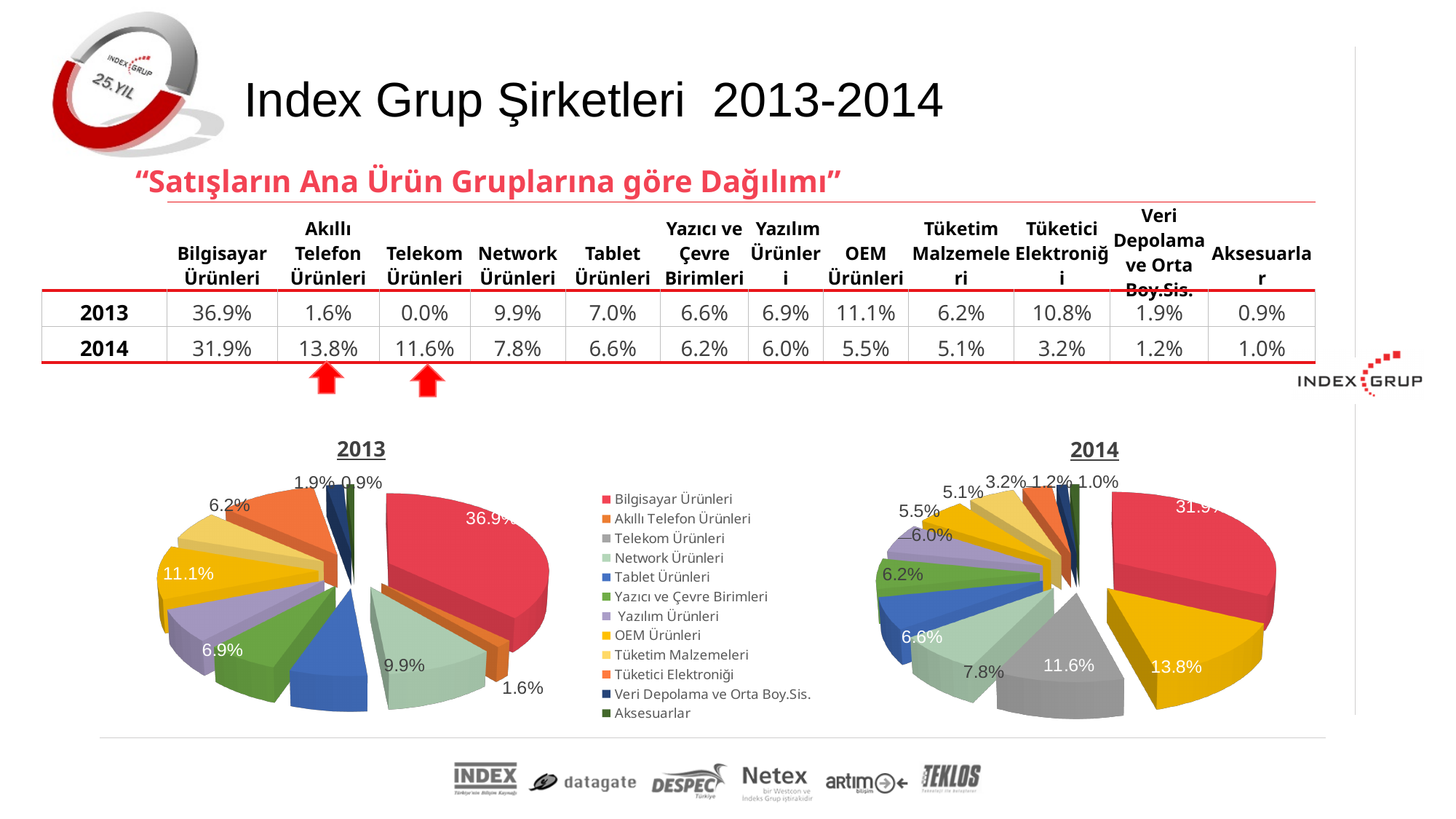
What kind of charts are shown on the slide for 2013 and 2014? Pie charts How many product groups does the legend between the two pie charts list? 12 In the 2013 pie chart, which product group has the largest slice? Bilgisayar Ürünleri In the 2014 pie chart, which product group has the smallest slice? Aksesuarlar In the 2014 pie chart, what share is shown for Akıllı Telefon Ürünleri? 13.8% In the 2013 pie chart, which is larger: OEM Ürünleri or Network Ürünleri? OEM Ürünleri In the 2014 pie chart, which is larger: Network Ürünleri or Tablet Ürünleri? Network Ürünleri By how many percentage points did the Bilgisayar Ürünleri share fall from the 2013 pie chart to the 2014 pie chart? 5.0 percentage points In the 2013 pie chart, what share is shown for OEM Ürünleri? 11.1% In the 2014 pie chart, how many percentage points larger is Bilgisayar Ürünleri than Akıllı Telefon Ürünleri? 18.1 percentage points What colour represents Bilgisayar Ürünleri in the pie chart legend? Red In the 2014 pie chart, what share is shown for Telekom Ürünleri? 11.6%